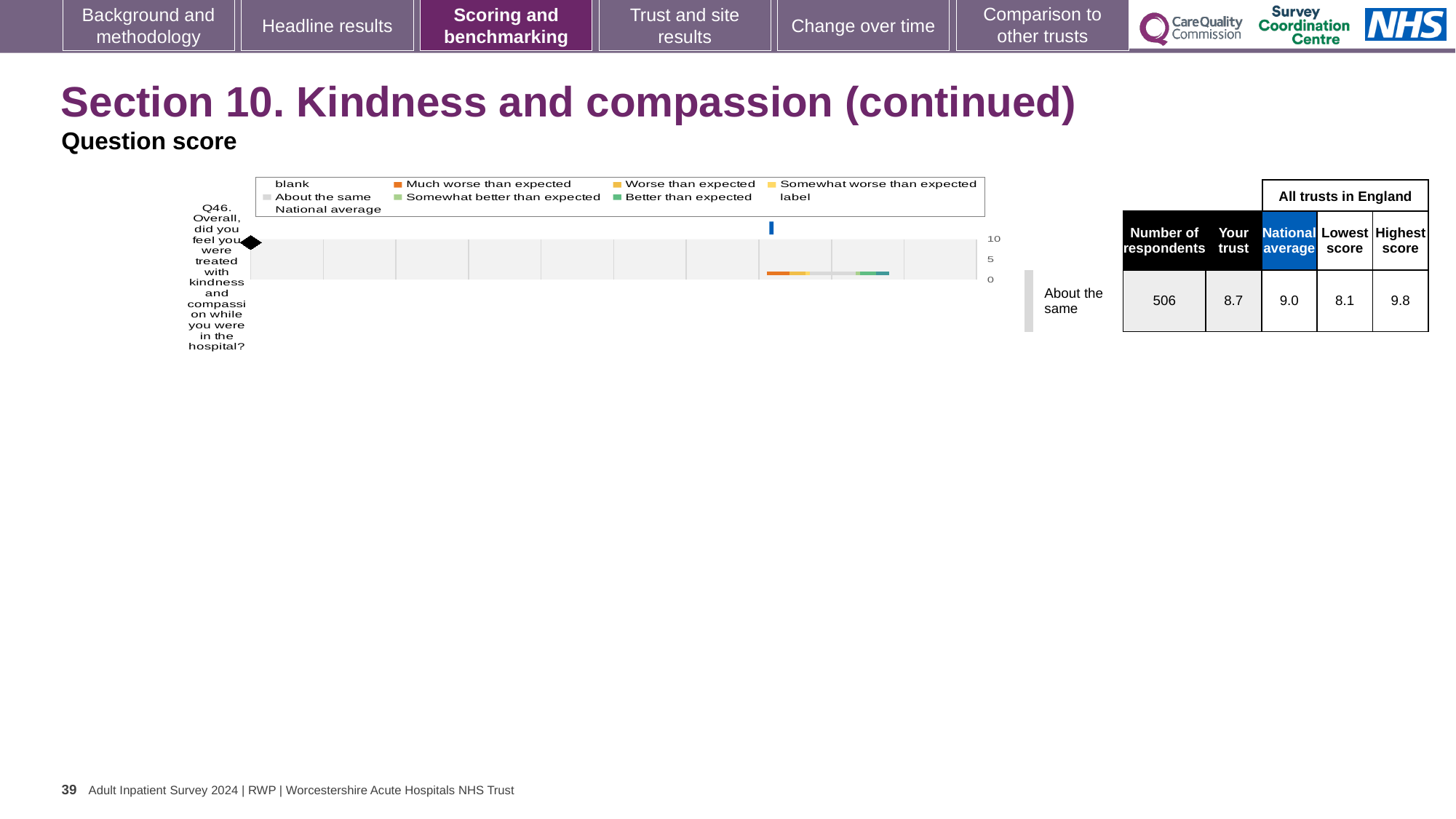
What is the National average score for Q46? 9.0 What kind of chart is shown on the slide? bar chart What is the Lowest score among all trusts in England for Q46? 8.1 What is the difference between the Highest score and the Lowest score for Q46? 1.7 How many entries does the chart legend list? 9 How many respondents answered Q46? 506 Which question number is plotted on the chart? Q46 How is the trust's Q46 result categorised relative to expectation? About the same What is the highest value shown on the chart's axis? 10 What is the Highest score among all trusts in England for Q46? 9.8 Which is larger for Q46, the Your trust score or the National average? National average What is the score for Your trust on Q46? 8.7